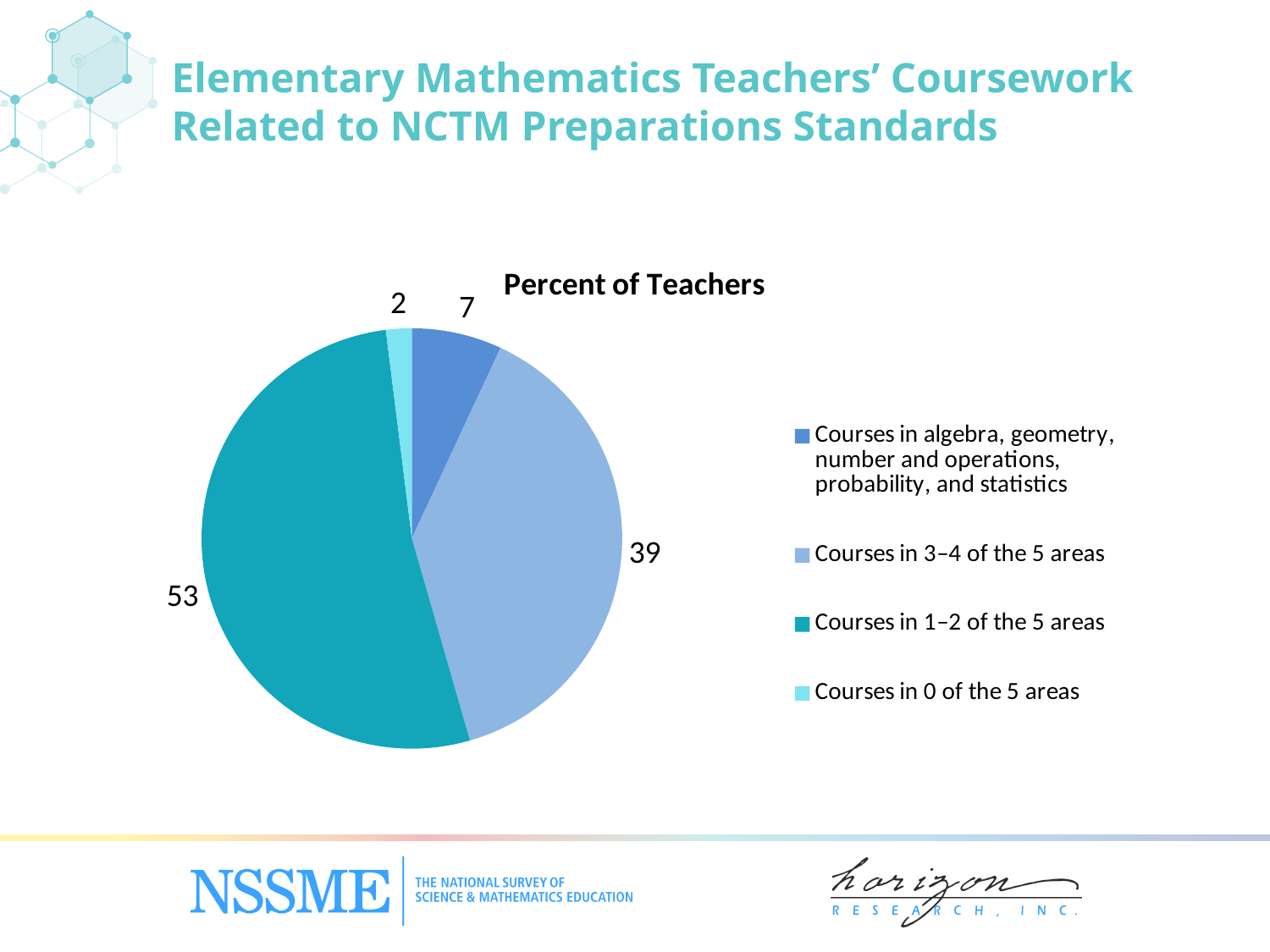
What percent of teachers had courses in 0 of the 5 areas? 2 What is the title of the chart? Percent of Teachers What percent of teachers had courses in algebra, geometry, number and operations, probability, and statistics? 7 What is the difference between the percent of teachers with courses in 1–2 of the 5 areas and those with courses in 3–4 of the 5 areas? 14 What percent of teachers had courses in 1–2 of the 5 areas? 53 What colour is the slice for courses in 1–2 of the 5 areas? teal Which category has the smallest slice of the pie? Courses in 0 of the 5 areas Which category has the largest slice of the pie? Courses in 1–2 of the 5 areas How many categories does the pie chart have? 4 Which is larger: the slice for courses in all five areas (algebra, geometry, number and operations, probability, and statistics) or the slice for courses in 0 of the 5 areas? Courses in algebra, geometry, number and operations, probability, and statistics What percent of teachers had courses in 3–4 of the 5 areas? 39 What kind of chart is shown on the slide? pie chart